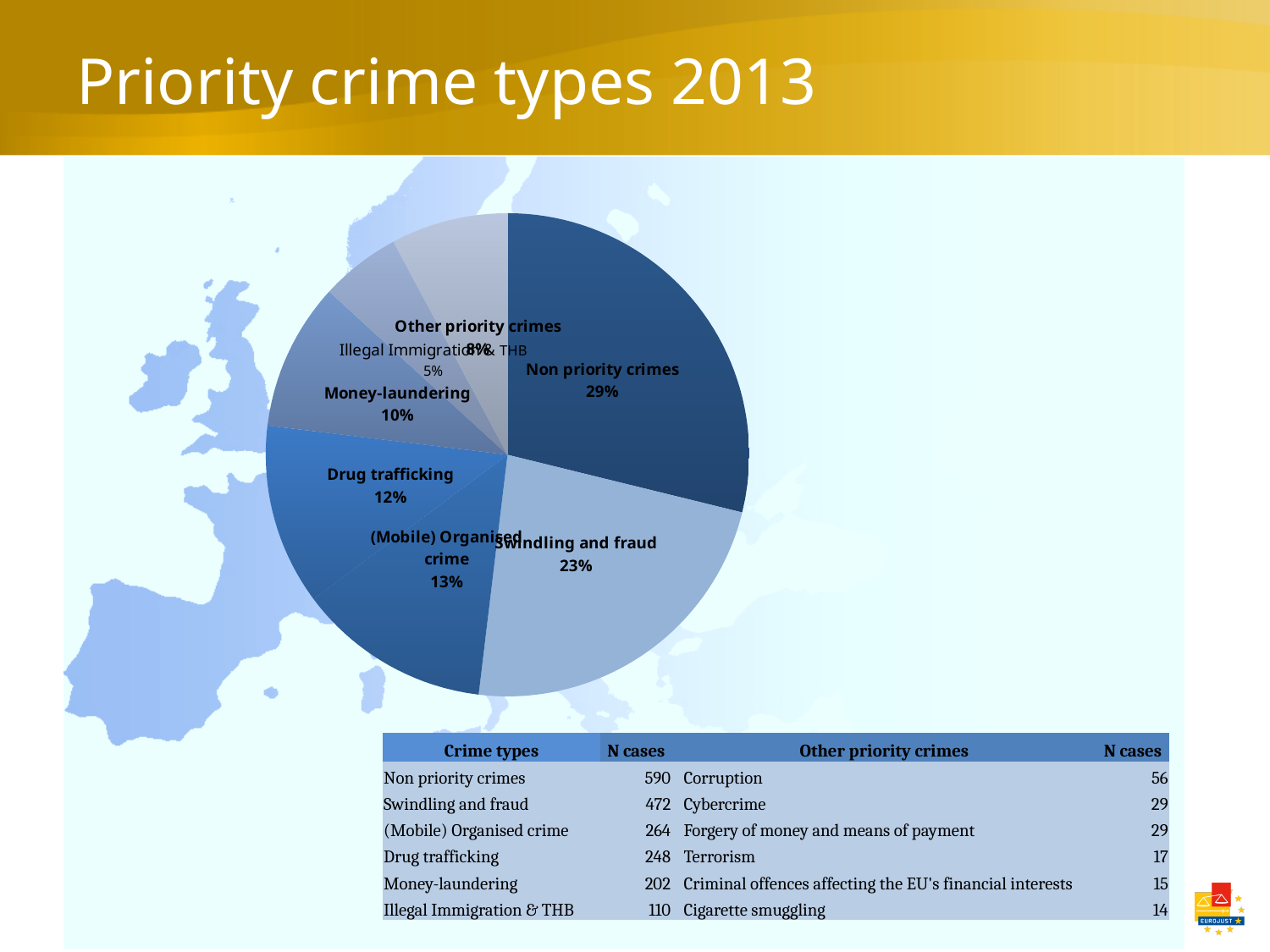
What percentage is shown for Drug trafficking in the pie chart? 12% What kind of chart is shown on the slide? pie chart What is the difference in percentage points between Non priority crimes and Swindling and fraud? 6 What percentage is shown for Money-laundering in the pie chart? 10% Which slice of the pie chart is the largest? Non priority crimes What share of the pie does Non priority crimes hold? 29% How many slices does the pie chart have? 7 Which is larger in the pie chart, Drug trafficking or Money-laundering? Drug trafficking What percentage is shown for (Mobile) Organised crime in the pie chart? 13% Which slice of the pie chart is the smallest? Illegal Immigration & THB What is the title of the slide containing the pie chart? Priority crime types 2013 What share of the pie does Swindling and fraud hold? 23%